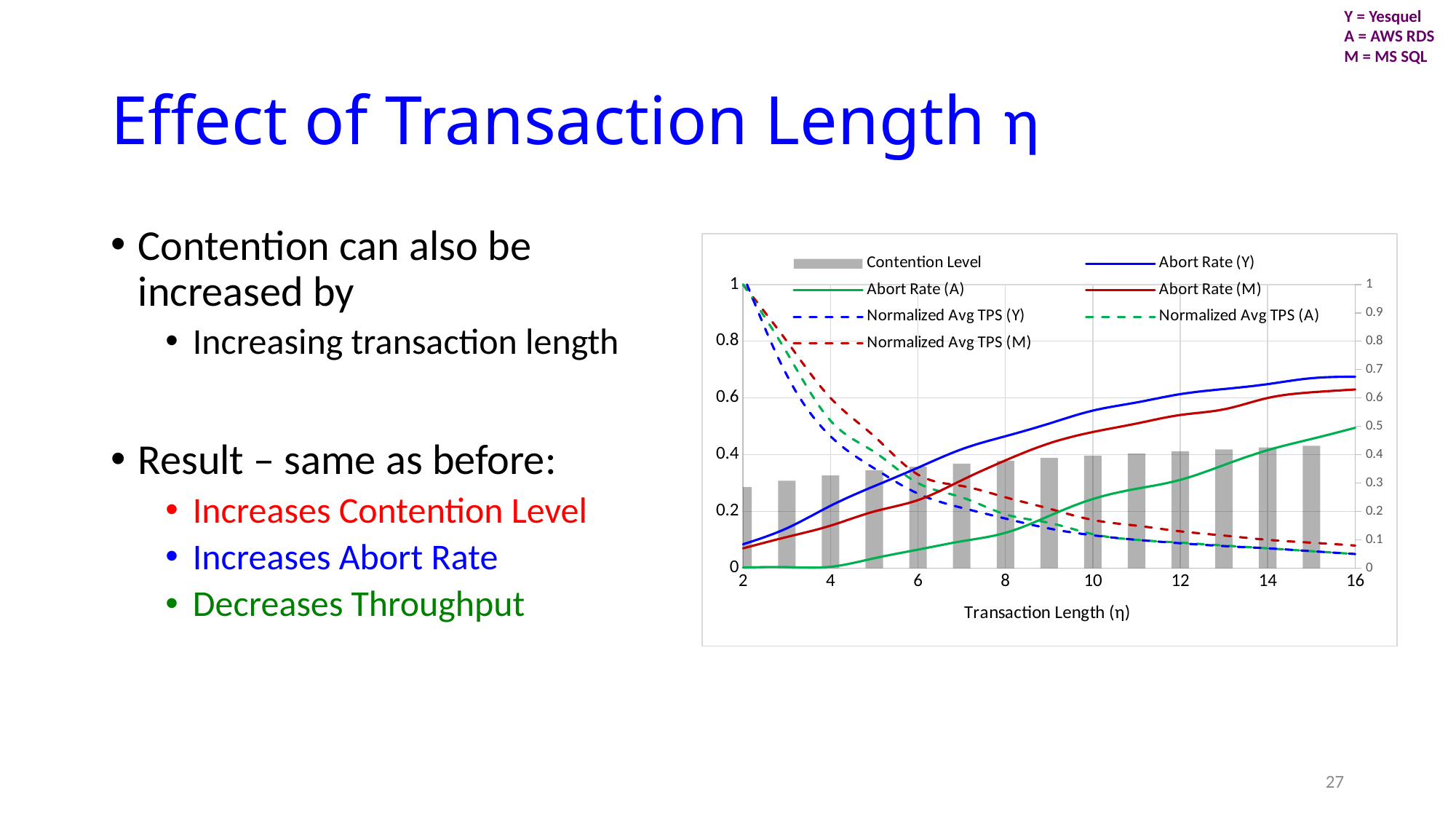
At transaction length 16, which is larger: Abort Rate (Y) or Abort Rate (A)? Abort Rate (Y) Which series in the chart is drawn as bars? Contention Level Is the value of Abort Rate (A) at transaction length 16 greater or less than 0.4? greater Does the Normalized Avg TPS (M) line rise or fall as transaction length increases? Falls Do the Contention Level bars rise or fall as transaction length increases? Rise Which of the three abort rate series has the highest value at transaction length 16? Abort Rate (Y) What is the title of the x axis of the chart? Transaction Length (η) Is the value of Abort Rate (Y) at transaction length 16 greater or less than 0.6? greater Is the value of Normalized Avg TPS (M) at transaction length 16 greater or less than 0.2? less How many series does the chart legend list? 7 What kind of chart is shown on the slide? A combination bar and line chart Does the Abort Rate (Y) line rise or fall as transaction length increases? Rises